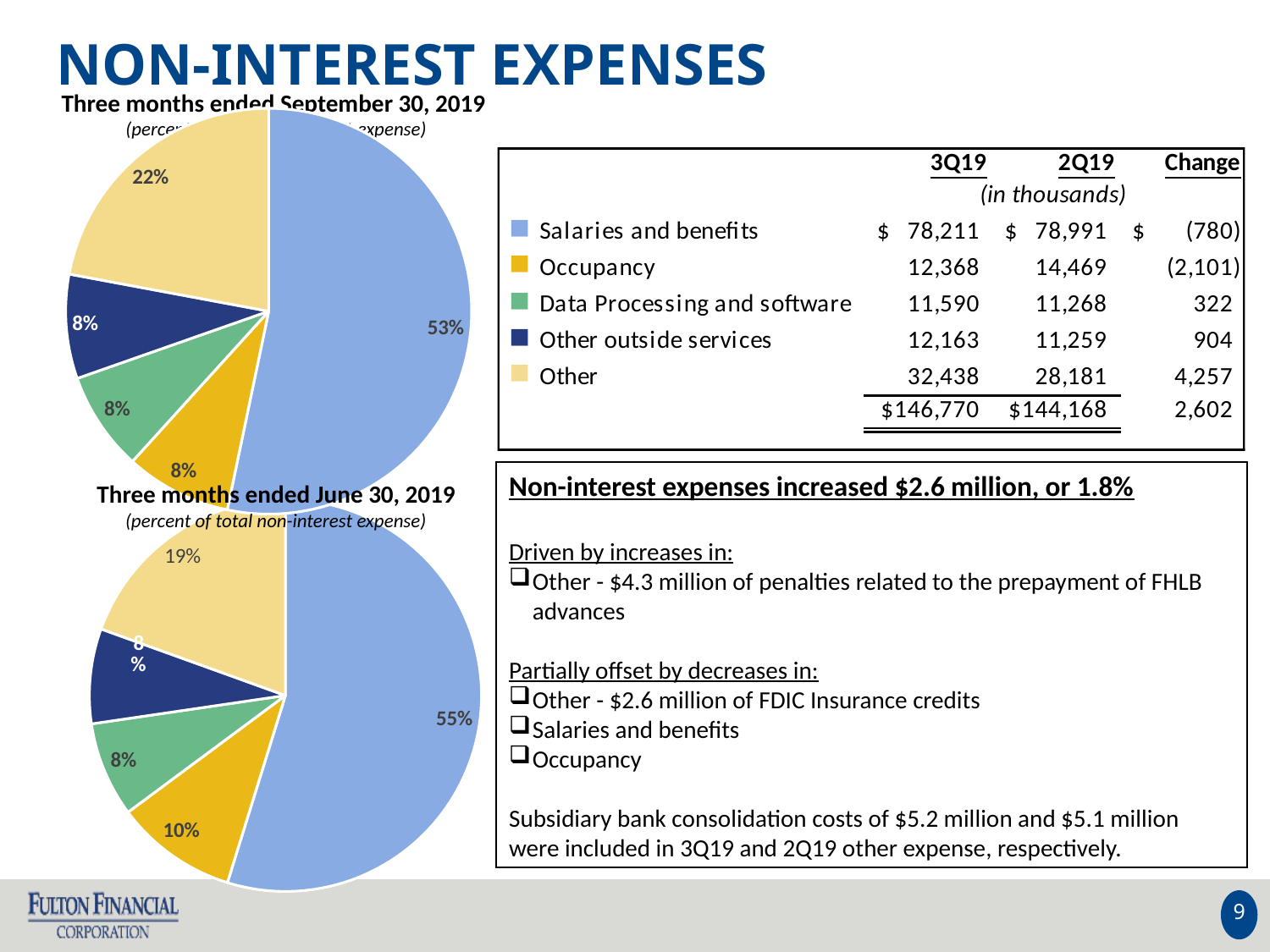
In the pie chart for the three months ended June 30, 2019, what share of total non-interest expense is Salaries and benefits? 55% In the pie chart for the three months ended September 30, 2019, what share of total non-interest expense is Salaries and benefits? 53% How many slices does the pie chart for the three months ended September 30, 2019 have? 5 In the pie chart for the three months ended June 30, 2019, what percentage is shown for the Other slice? 19% In the pie chart for the three months ended June 30, 2019, which category has the largest slice? Salaries and benefits What is the difference in percentage points between the Other slice in the September 30, 2019 pie chart and the Other slice in the June 30, 2019 pie chart? 3 percentage points In the pie chart for the three months ended September 30, 2019, what percentage is shown for the Other slice? 22% Is the Occupancy share larger in the pie chart for the three months ended September 30, 2019 or in the pie chart for the three months ended June 30, 2019? June 30, 2019 In the pie chart for the three months ended June 30, 2019, what percentage is shown for Occupancy? 10% In the pie chart for the three months ended September 30, 2019, which category has the largest slice? Salaries and benefits In the pie chart for the three months ended September 30, 2019, what percentage is shown for Data Processing and software? 8% What type of chart is used to show the breakdown of non-interest expense for the three months ended June 30, 2019? Pie chart